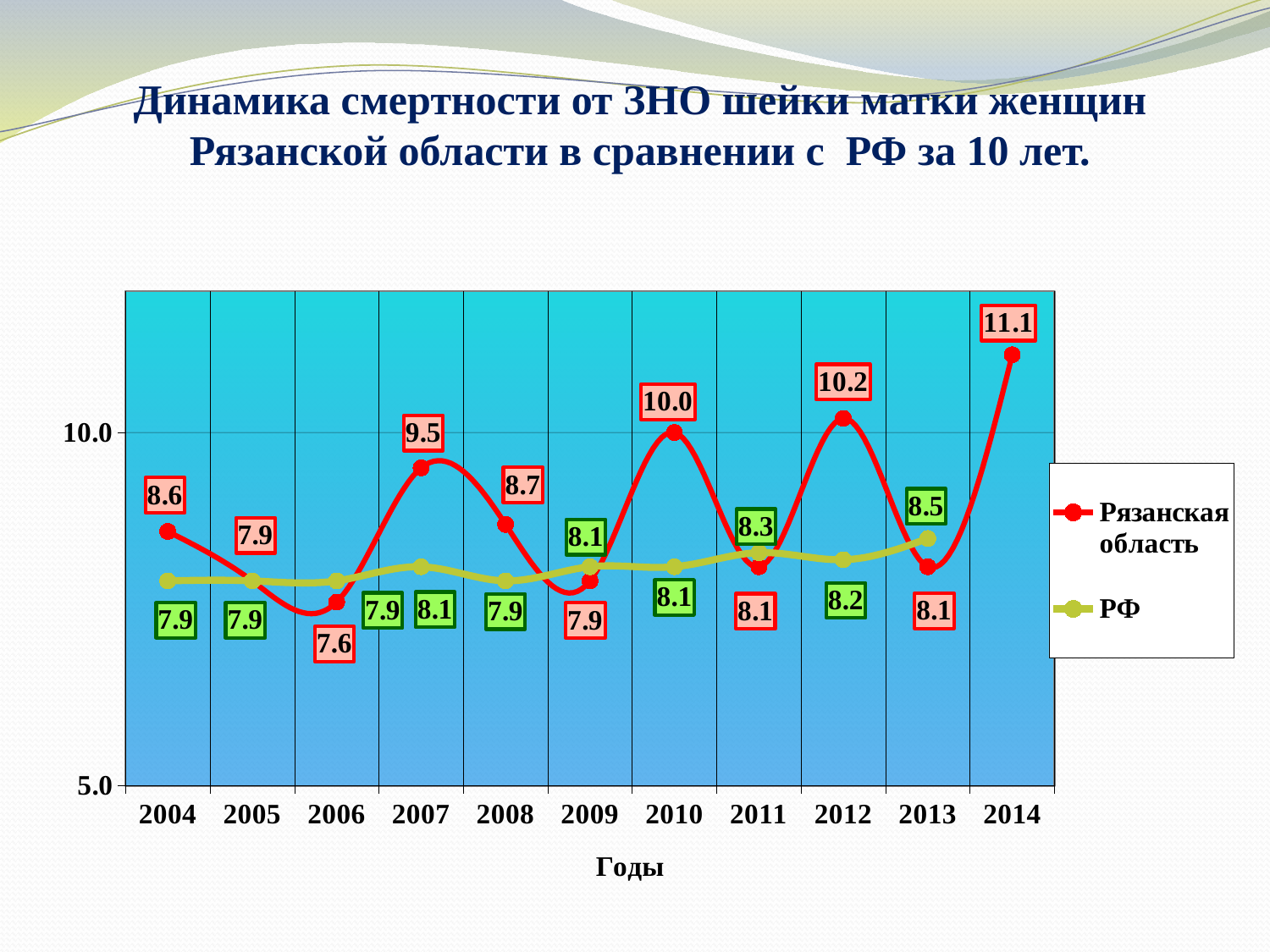
Is the value for Рязанская область in 2014 greater or less than 10.0? greater What is the value for Рязанская область in 2014? 11.1 In which year is the value for Рязанская область lowest? 2006 What kind of chart is shown on the slide? line chart Which series has the larger value in 2007, Рязанская область or РФ? Рязанская область What is the value for РФ in 2013? 8.5 What is the difference between the Рязанская область value and the РФ value in 2012? 2.0 In which year is the value for Рязанская область highest? 2014 What is the title of the x axis? Годы What is the value for Рязанская область in 2010? 10.0 How many years are shown on the x axis? 11 How many series does the legend list? 2